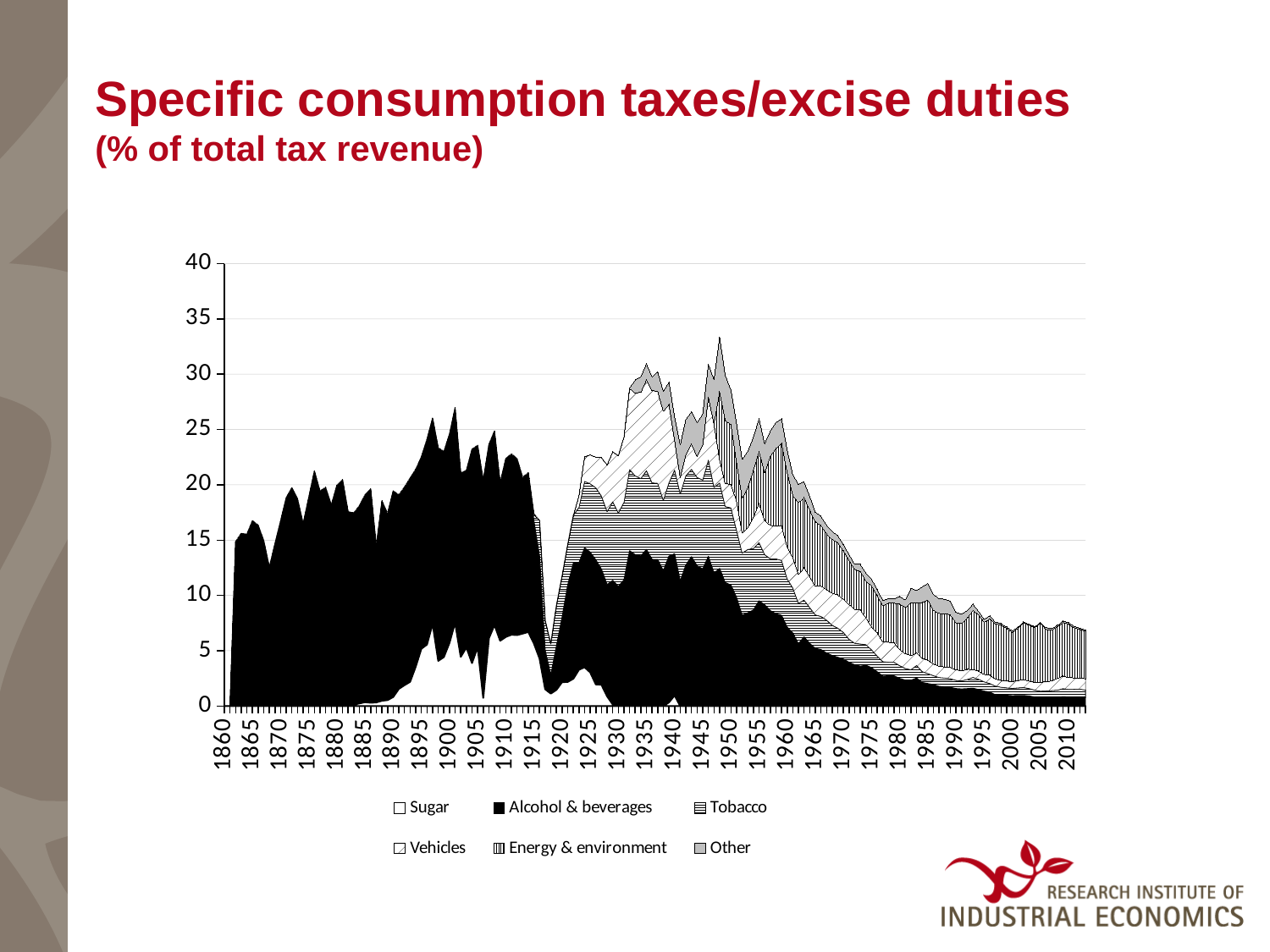
What is the title of the chart on the slide? Specific consumption taxes/excise duties (% of total tax revenue) Which series is listed first in the legend? Sugar Does the total of the stacked areas rise or fall between 1920 and 1935? rise Does the total of the stacked areas rise or fall between 1950 and 2010? fall Is the total value of the stacked areas around 1920 greater or less than 5? greater Which series makes up the largest part of the stacked total in 2010? Energy & environment How many series does the legend list? 6 Which series makes up almost all of the stacked total before 1915? Alcohol & beverages Is the total value of the stacked areas in 2010 greater or less than 10? less What kind of chart is shown on the slide? stacked area chart